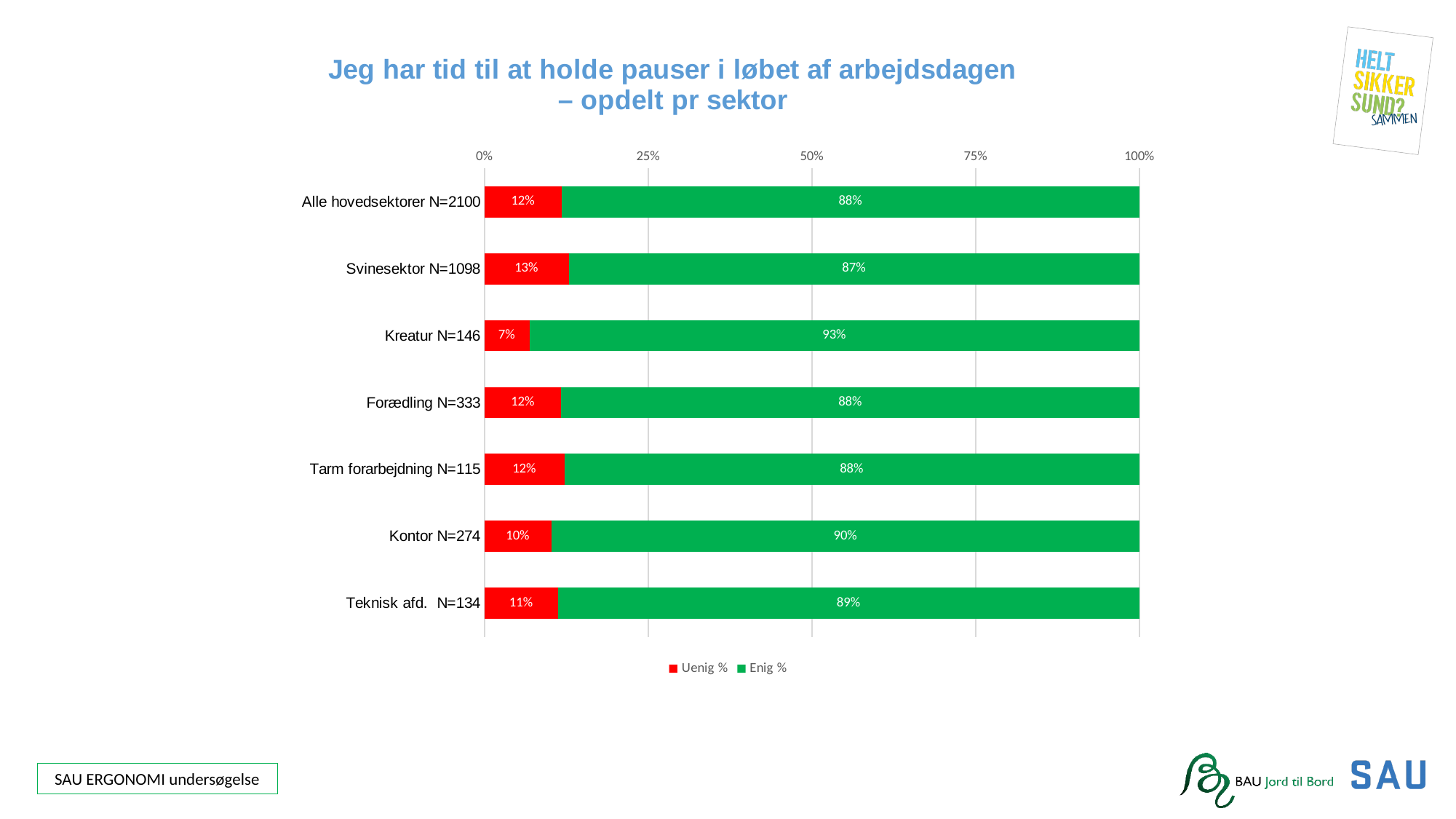
What is the Uenig % value for Svinesektor N=1098? 13% Which category has the lowest Uenig % value? Kreatur N=146 What is the Enig % value for Kontor N=274? 90% What is the difference between the Enig % values for Kreatur N=146 and Svinesektor N=1098? 6% Which is larger, the Uenig % value for Kontor N=274 or for Forædling N=333? Forædling N=333 Which category has the highest Uenig % value? Svinesektor N=1098 Which category has the highest Enig % value? Kreatur N=146 How many categories are shown on the chart? 7 What kind of chart is shown on the slide? Stacked bar chart How many series does the legend list? 2 What is the Enig % value for Kreatur N=146? 93% What is the Uenig % value for Teknisk afd. N=134? 11%